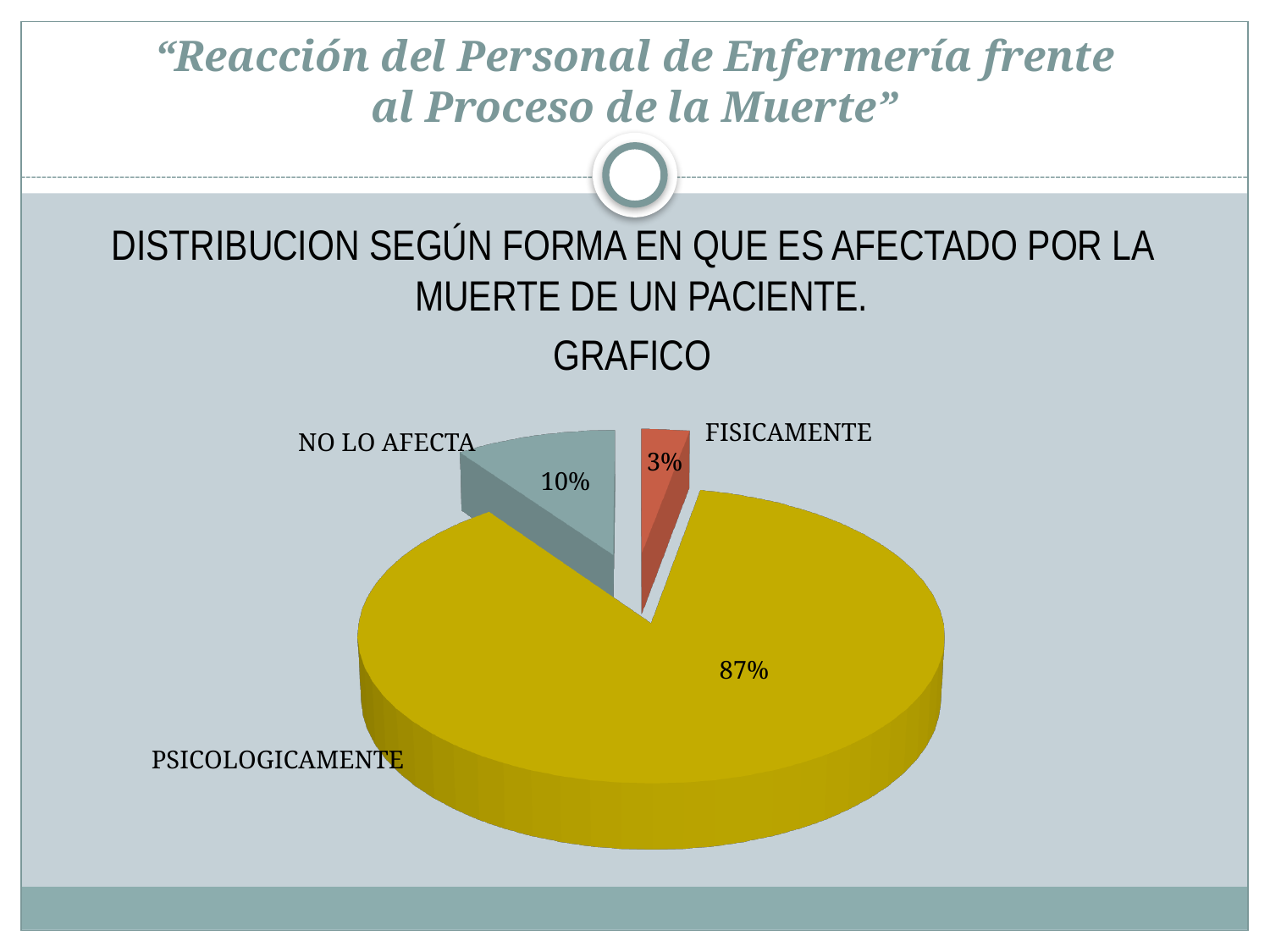
How many categories are shown in the pie chart? 3 What share of the pie does PSICOLOGICAMENTE represent? 87% What colour is the slice for PSICOLOGICAMENTE? Yellow What share of the pie does FISICAMENTE represent? 3% What kind of chart is shown on the slide? Pie chart What share of the pie does NO LO AFECTA represent? 10% Which is larger, the slice for NO LO AFECTA or the slice for FISICAMENTE? NO LO AFECTA What is the difference in percentage points between NO LO AFECTA and FISICAMENTE? 7 Which category has the smallest slice of the pie? FISICAMENTE What is the difference in percentage points between PSICOLOGICAMENTE and NO LO AFECTA? 77 What is the title of the chart on the slide? DISTRIBUCION SEGÚN FORMA EN QUE ES AFECTADO POR LA MUERTE DE UN PACIENTE. Which category has the largest slice of the pie? PSICOLOGICAMENTE